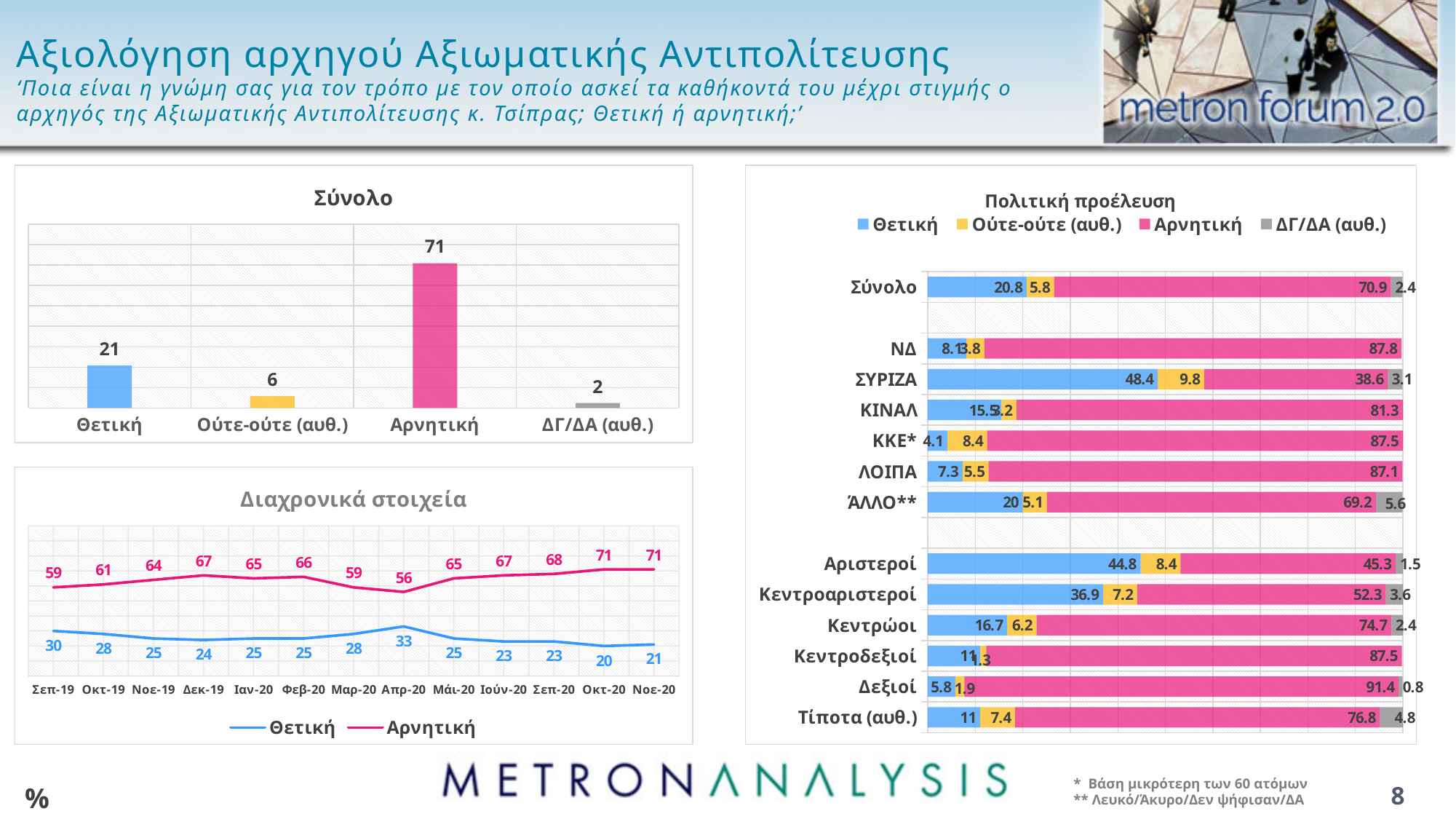
In the 'Σύνολο' bar chart, which category has the lowest value? ΔΓ/ΔΑ (αυθ.) In the 'Διαχρονικά στοιχεία' chart, what is the value of Θετική for Απρ-20? 33 In the 'Διαχρονικά στοιχεία' chart, what is the lowest value of the Αρνητική line? 56 In the 'Πολιτική προέλευση' chart, which is larger for Αριστεροί: Θετική or Αρνητική? Αρνητική In the 'Διαχρονικά στοιχεία' chart, does the Αρνητική line rise or fall from Μάι-20 to Νοε-20? rise In the 'Πολιτική προέλευση' chart, which group has the highest Αρνητική value? Δεξιοί What kind of chart is 'Διαχρονικά στοιχεία'? line chart In the 'Πολιτική προέλευση' chart, what is the Θετική value for ΣΥΡΙΖΑ? 48.4 In the 'Σύνολο' bar chart, what is the difference between Αρνητική and Θετική? 50 In the 'Σύνολο' bar chart, what is the value for Αρνητική? 71 How many series does the legend of the 'Πολιτική προέλευση' chart list? 4 In the 'Διαχρονικά στοιχεία' chart, how many time points are shown on the x axis? 13